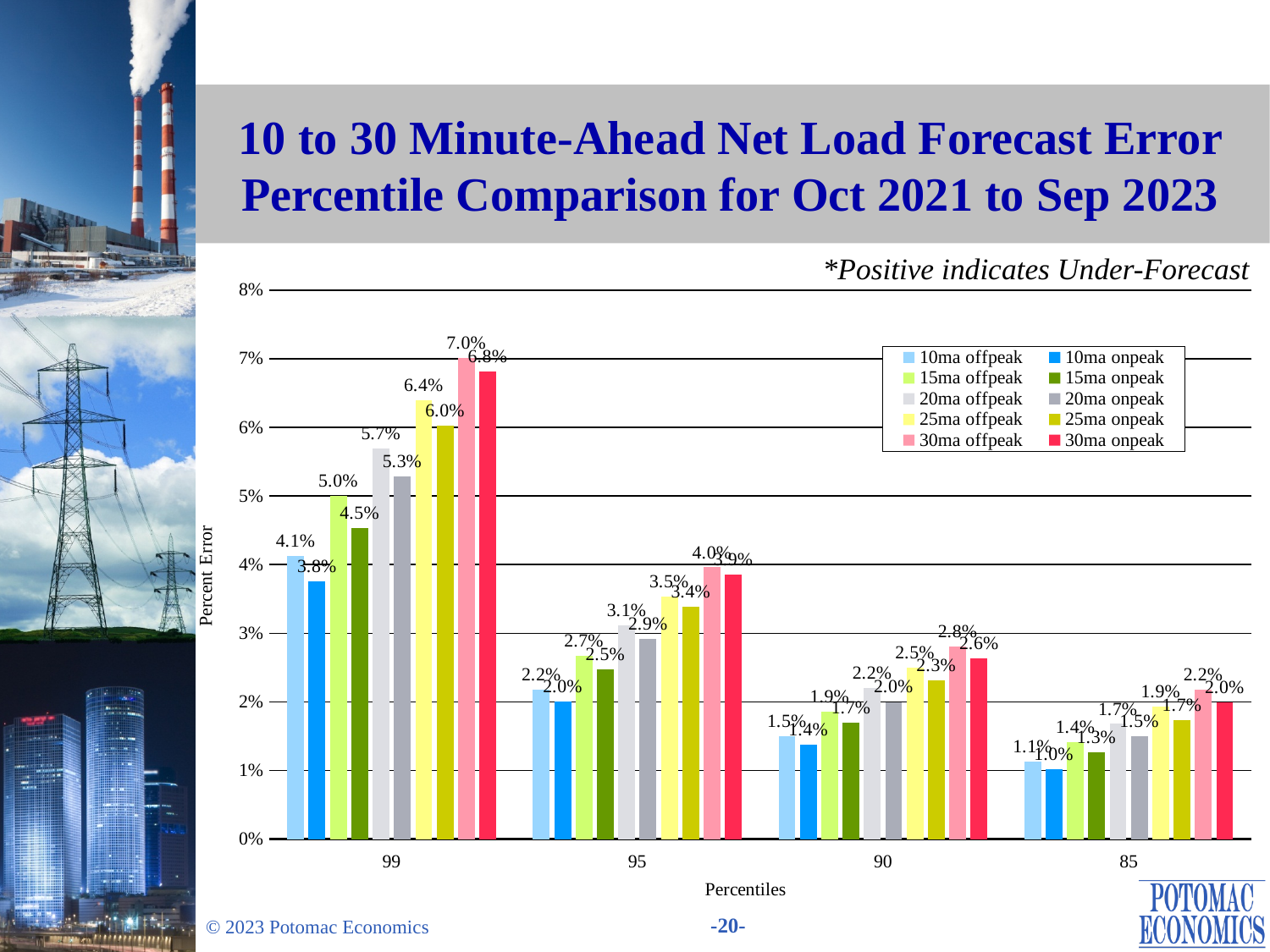
How many percentile categories are shown on the x axis? 4 What is the difference between the 30ma offpeak and 10ma offpeak values at the 99 percentile? 2.9 percentage points What is the value for 20ma offpeak at the 95 percentile? 3.1% What is the value for 25ma offpeak at the 99 percentile? 6.4% Do the values for 30ma offpeak rise or fall moving from the 99 percentile to the 85 percentile? fall What is the value for 10ma offpeak at the 99 percentile? 4.1% How many series does the legend list? 10 What is the value for 30ma offpeak at the 99 percentile? 7.0% What kind of chart is shown on the slide? bar chart Which series has the lowest value at the 99 percentile? 10ma onpeak What is the title of the y axis? Percent Error Which series has the highest value at the 99 percentile? 30ma offpeak